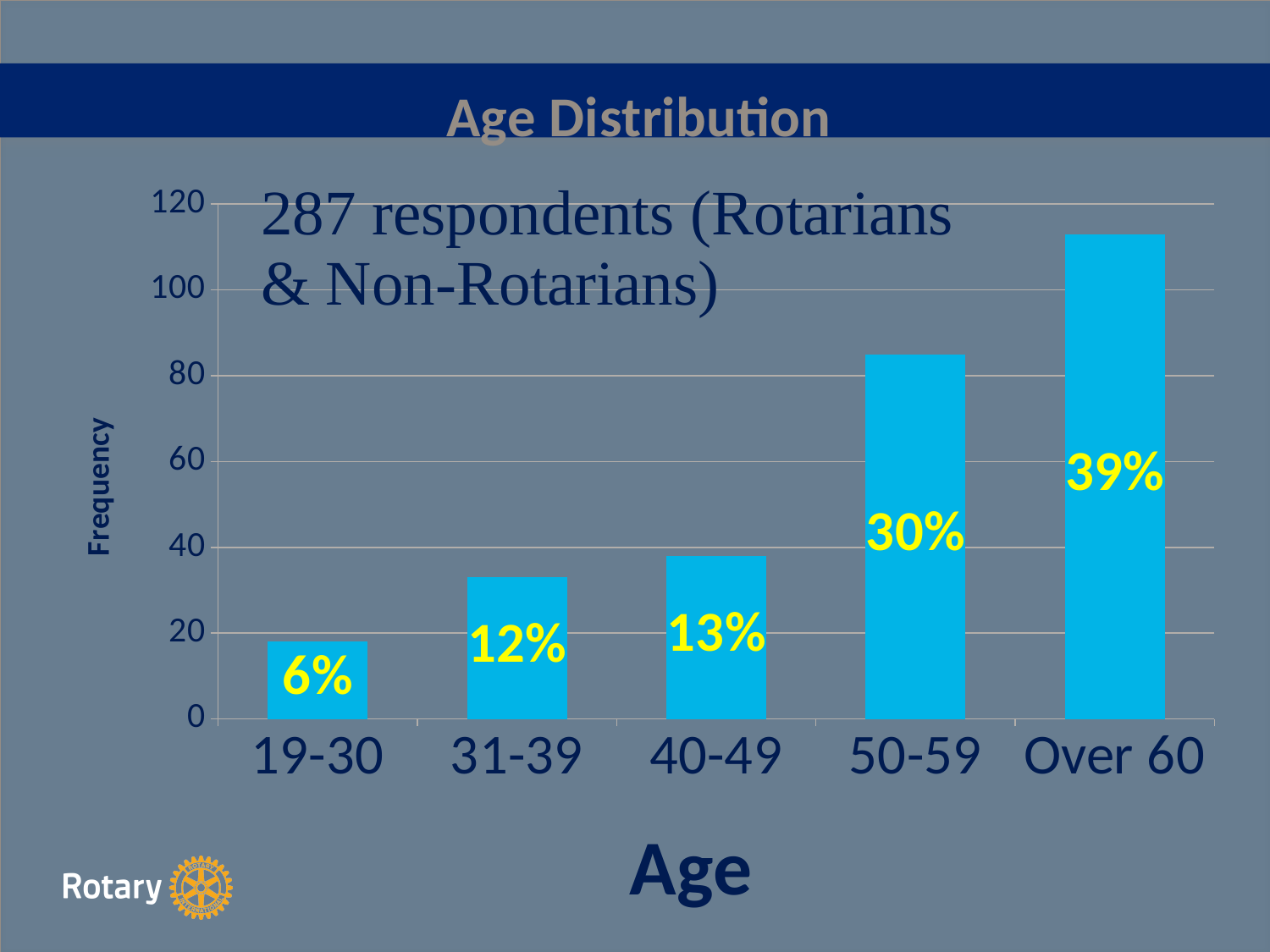
Is the frequency for the 50-59 age group greater or less than 80? greater How many age groups are shown on the x axis? 5 Which age group has the larger frequency, 31-39 or 50-59? 50-59 What kind of chart is shown on the slide? Bar chart Is the frequency for the 19-30 age group greater or less than 20? less Which age group has the lowest frequency? 19-30 What percentage label is shown on the bar for the 19-30 age group? 6% Which age group has the highest frequency? Over 60 Do the frequencies rise or fall as age increases along the x axis? Rise What percentage label is shown on the bar for the 50-59 age group? 30% What percentage label is shown on the bar for the Over 60 age group? 39% What is the difference in percentage points between the labels for Over 60 and 50-59? 9 percentage points